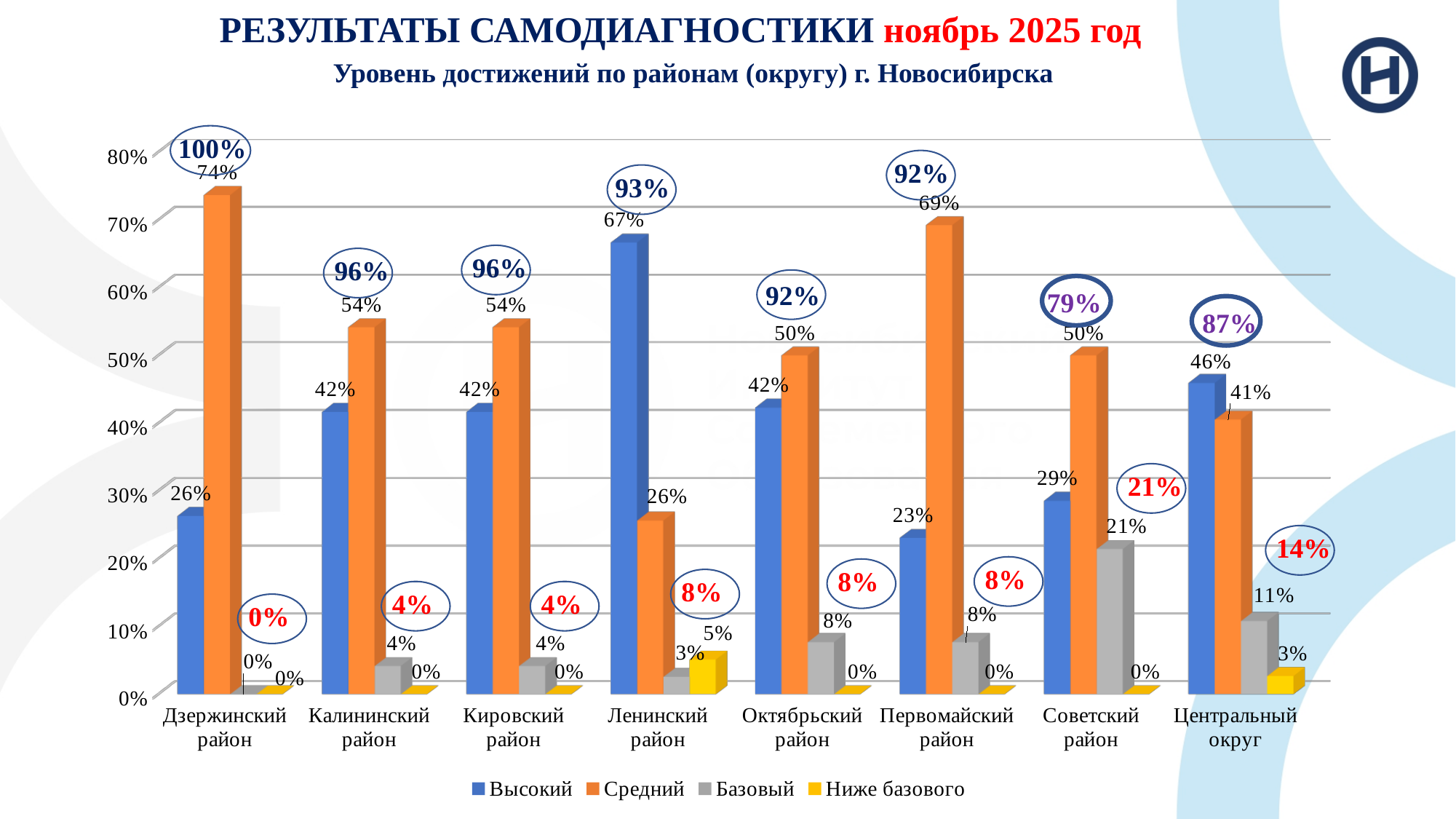
What is the value of the Средний series for Дзержинский район? 74% What is the value of the Ниже базового series for Центральный округ? 3% What is the value of the Высокий series for Ленинский район? 67% What is the value of the Базовый series for Советский район? 21% How many districts are shown on the x axis? 8 What is the difference between the Средний and Высокий values for Первомайский район? 46% How many series does the legend list? 4 Which district has the highest value in the Средний series? Дзержинский район What kind of chart is shown on the slide? Bar chart Which district has the lowest value in the Высокий series? Первомайский район Which is larger for Центральный округ: the Высокий value or the Средний value? Высокий Which district has the highest value in the Высокий series? Ленинский район